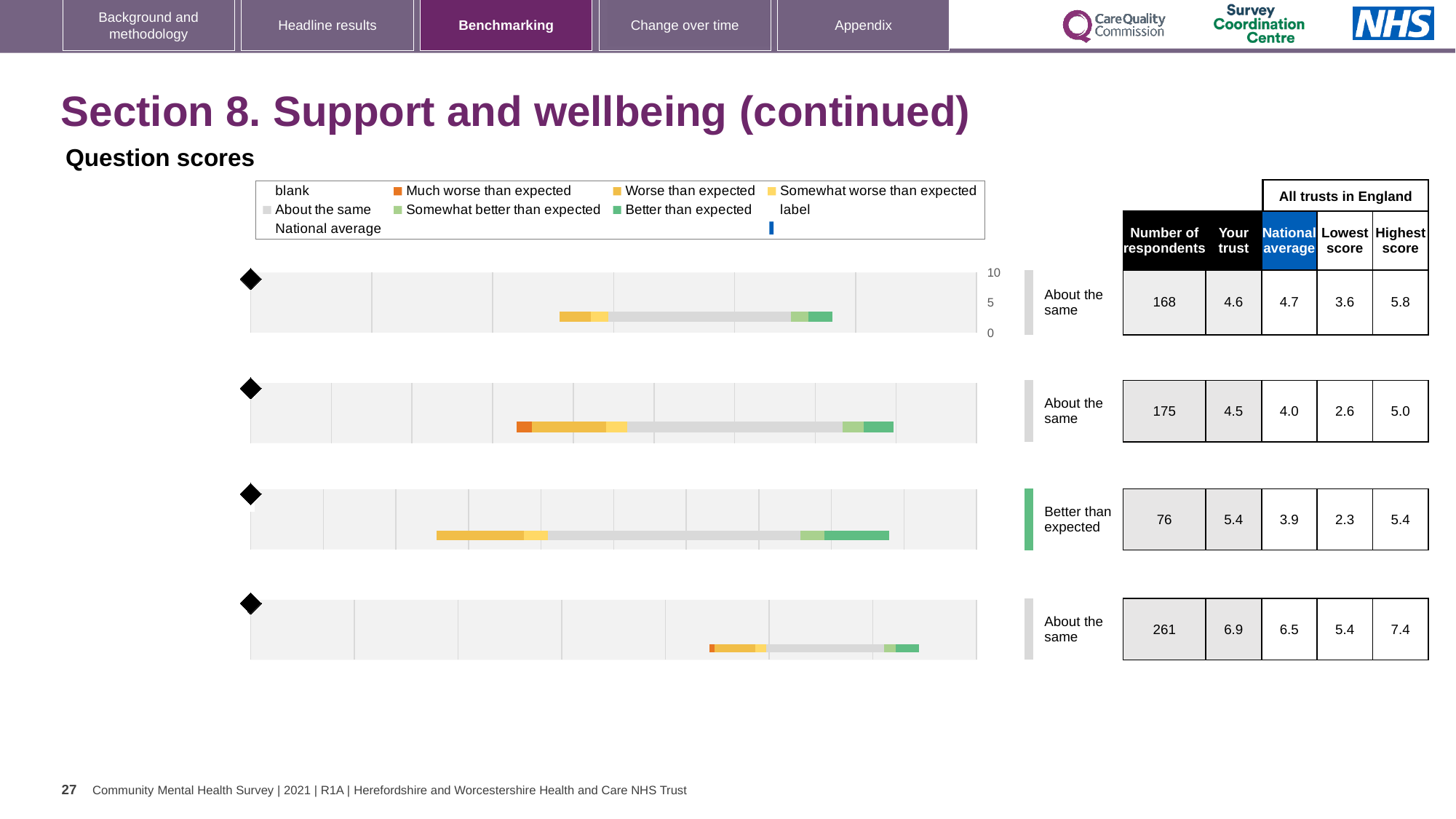
Which bar has the highest 'Your trust' score? the fourth (bottom) bar For the third bar, how many respondents are there? 76 For the fourth (bottom) bar, what is the difference between the highest score and the lowest score? 2.0 What kind of chart is used to show the question scores on this slide? bar chart For the first (top) bar, what is the national average score? 4.7 Which bar is rated 'Better than expected'? the third bar What is the maximum value shown on the score axis of the charts? 10 For the first (top) bar, what is the 'Your trust' score? 4.6 For the fourth (bottom) bar, what is the 'Your trust' score? 6.9 For the third bar, which is larger: the 'Your trust' score or the national average? Your trust For the second bar, what is the lowest score among all trusts in England? 2.6 How many question score bars are shown on the slide? 4